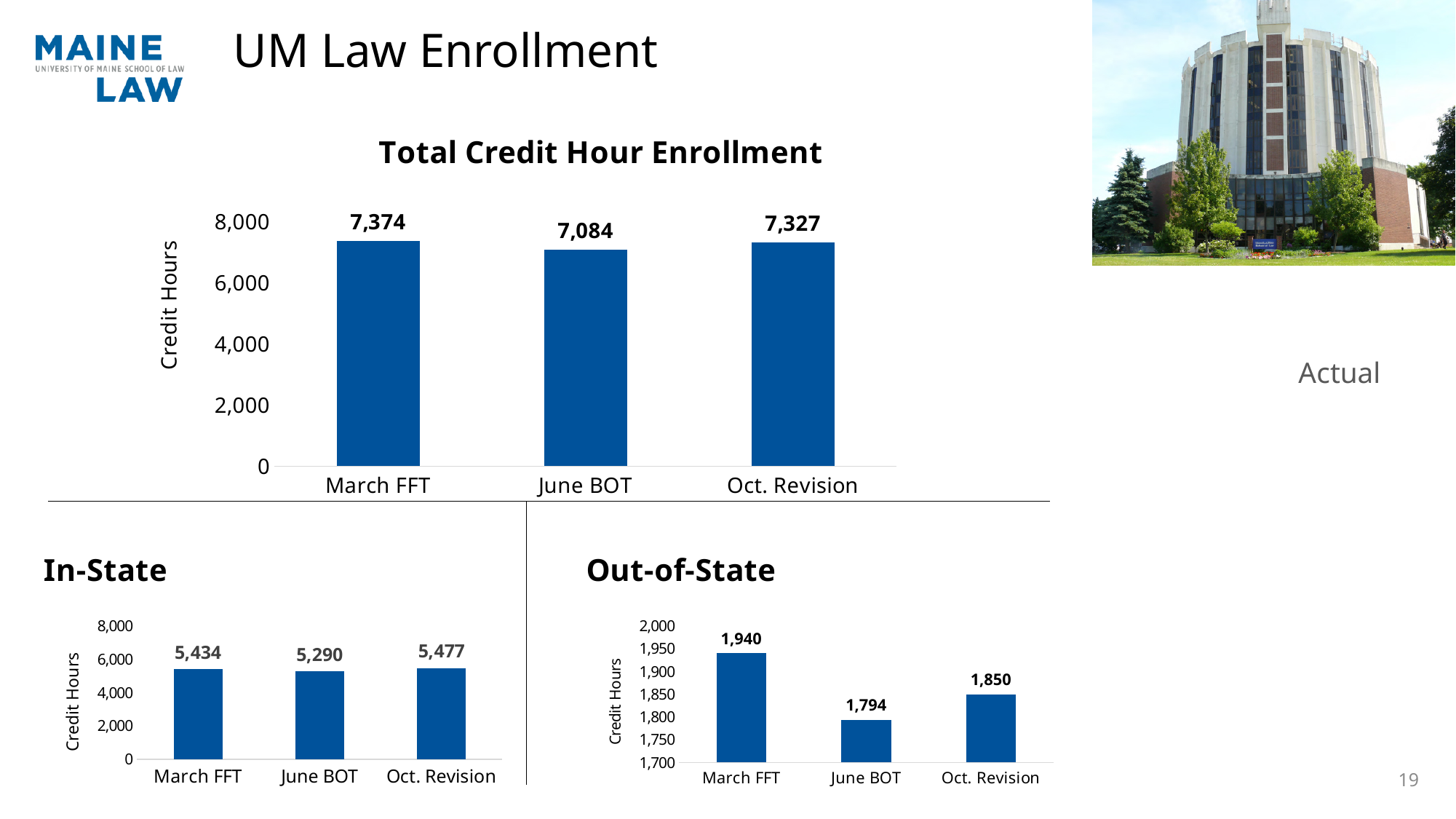
In the Out-of-State chart, which is larger, June BOT or Oct. Revision? Oct. Revision In the Out-of-State chart, what is the difference between March FFT and June BOT? 146 In the Total Credit Hour Enrollment chart, which category has the highest value? March FFT How many categories are shown in the In-State chart? 3 What is the y-axis label of the Out-of-State chart? Credit Hours In the Out-of-State chart, what is the value for March FFT? 1,940 In the Total Credit Hour Enrollment chart, what is the difference between March FFT and June BOT? 290 In the In-State chart, what is the value for Oct. Revision? 5,477 In the Out-of-State chart, is the value for Oct. Revision greater or less than 1,900? less What kind of chart is the Total Credit Hour Enrollment chart? bar chart In the Total Credit Hour Enrollment chart, what is the value for June BOT? 7,084 In the In-State chart, which category has the lowest value? June BOT